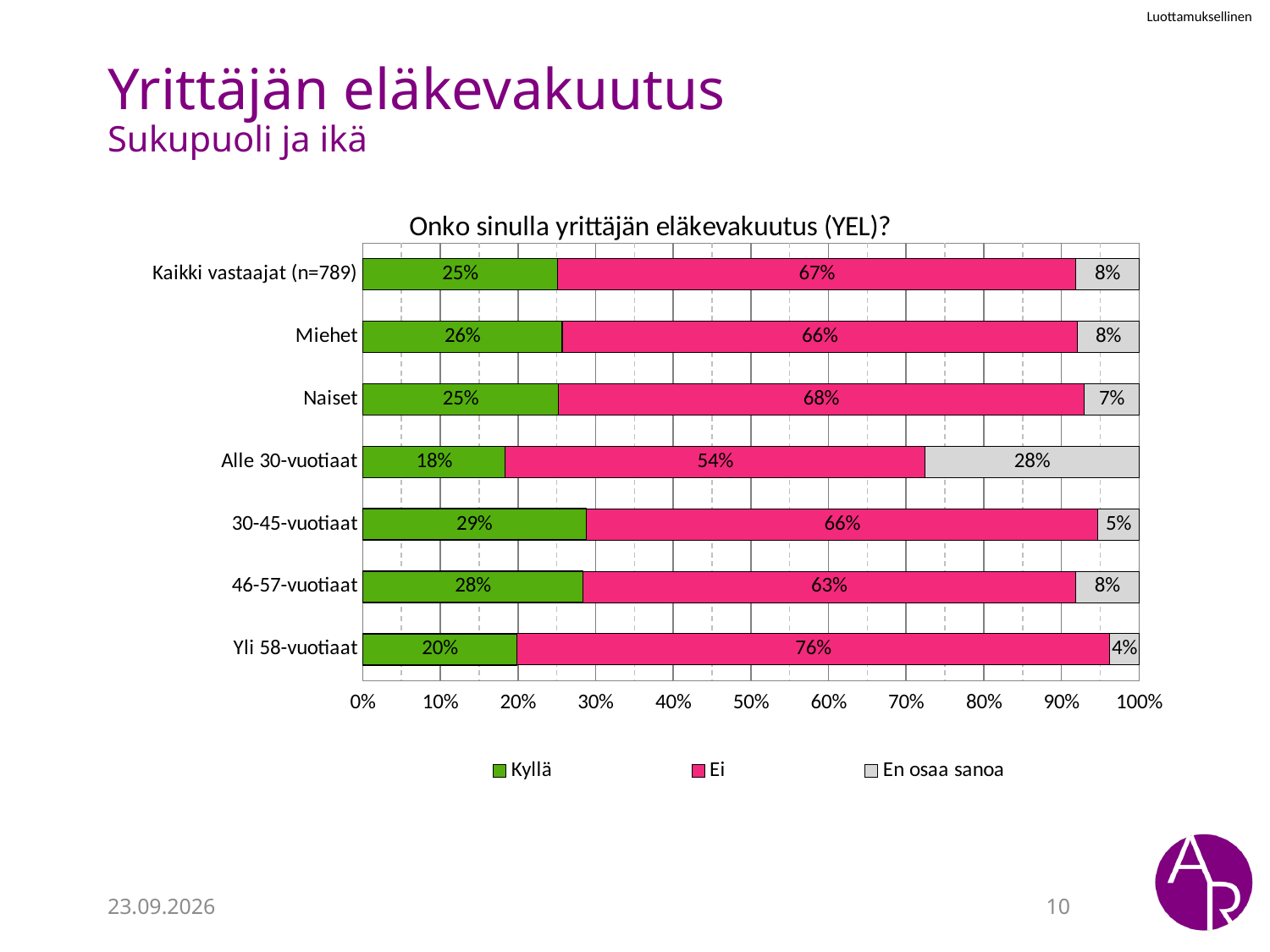
What kind of chart is shown? Stacked bar chart What is the total of the stacked bar for Kaikki vastaajat (n=789)? 100% How many series does the legend list? 3 What is the difference between the 'Ei' values for Naiset and Alle 30-vuotiaat? 14% What is the 'Ei' value for Yli 58-vuotiaat? 76% Which category has the highest 'Ei' value? Yli 58-vuotiaat Which category has the lowest 'Kyllä' value? Alle 30-vuotiaat What is the title of the chart? Onko sinulla yrittäjän eläkevakuutus (YEL)? Which is larger: the 'Kyllä' value for 30-45-vuotiaat or for 46-57-vuotiaat? 30-45-vuotiaat What is the 'Kyllä' value for Miehet? 26% How many categories are shown on the y axis? 7 What is the 'En osaa sanoa' value for Alle 30-vuotiaat? 28%